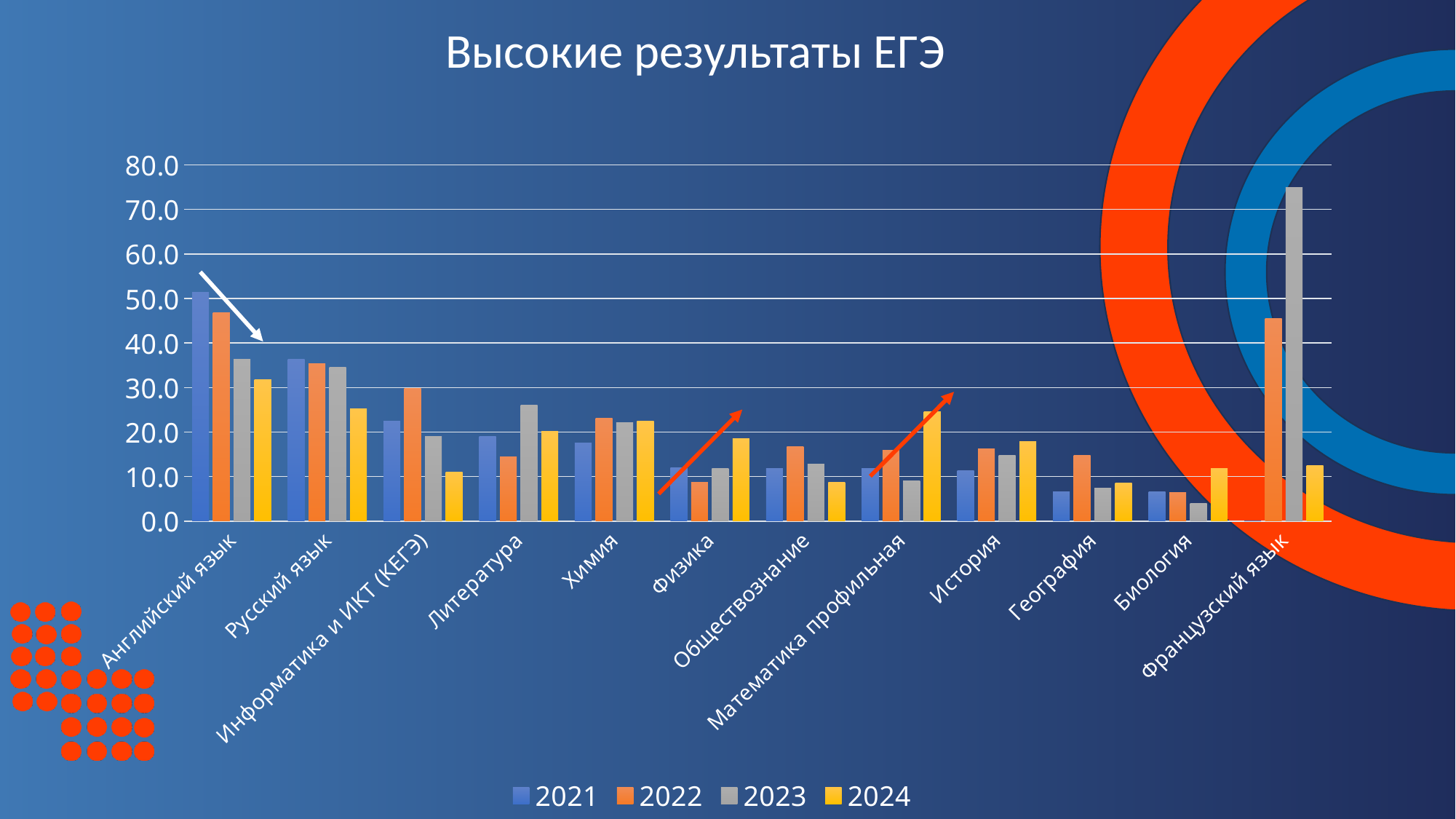
Is the 2024 value for Информатика и ИКТ (КЕГЭ) greater or less than 20? less For Физика, which year has the larger value: 2022 or 2024? 2024 What is the title of the chart? Высокие результаты ЕГЭ For Биология, which year has the lowest value? 2023 What kind of chart is shown on the slide? bar chart Is the 2023 value for Французский язык greater or less than 70? greater How many subject categories are shown on the x axis? 12 Do the values for Английский язык rise or fall from 2021 to 2024? fall Which subject has the tallest bar in the chart? Французский язык Is the 2021 value for Английский язык greater or less than 40? greater How many series does the legend list? 4